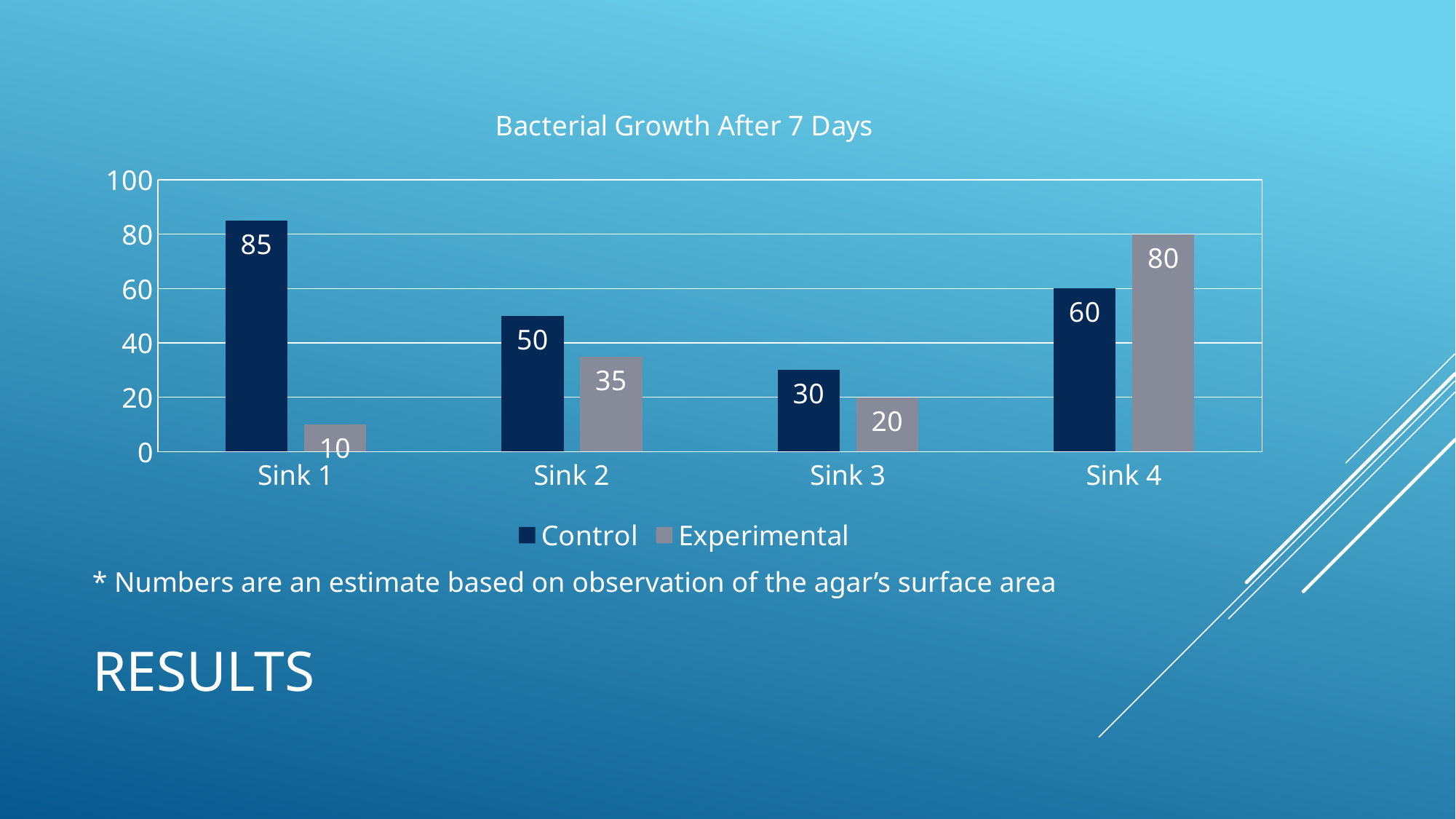
How many series does the legend list? 2 What is the Control value for Sink 1? 85 What is the difference between the Control and Experimental values for Sink 1? 75 Which sink has the lowest Experimental value? Sink 1 What is the Experimental value for Sink 2? 35 Which is larger for Sink 4, the Control value or the Experimental value? Experimental What is the title of the chart? Bacterial Growth After 7 Days Which sink has the highest Control value? Sink 1 What kind of chart is shown on the slide? Bar chart What is the difference between the Control values for Sink 2 and Sink 3? 20 What is the Experimental value for Sink 4? 80 How many sinks are shown on the x axis? 4